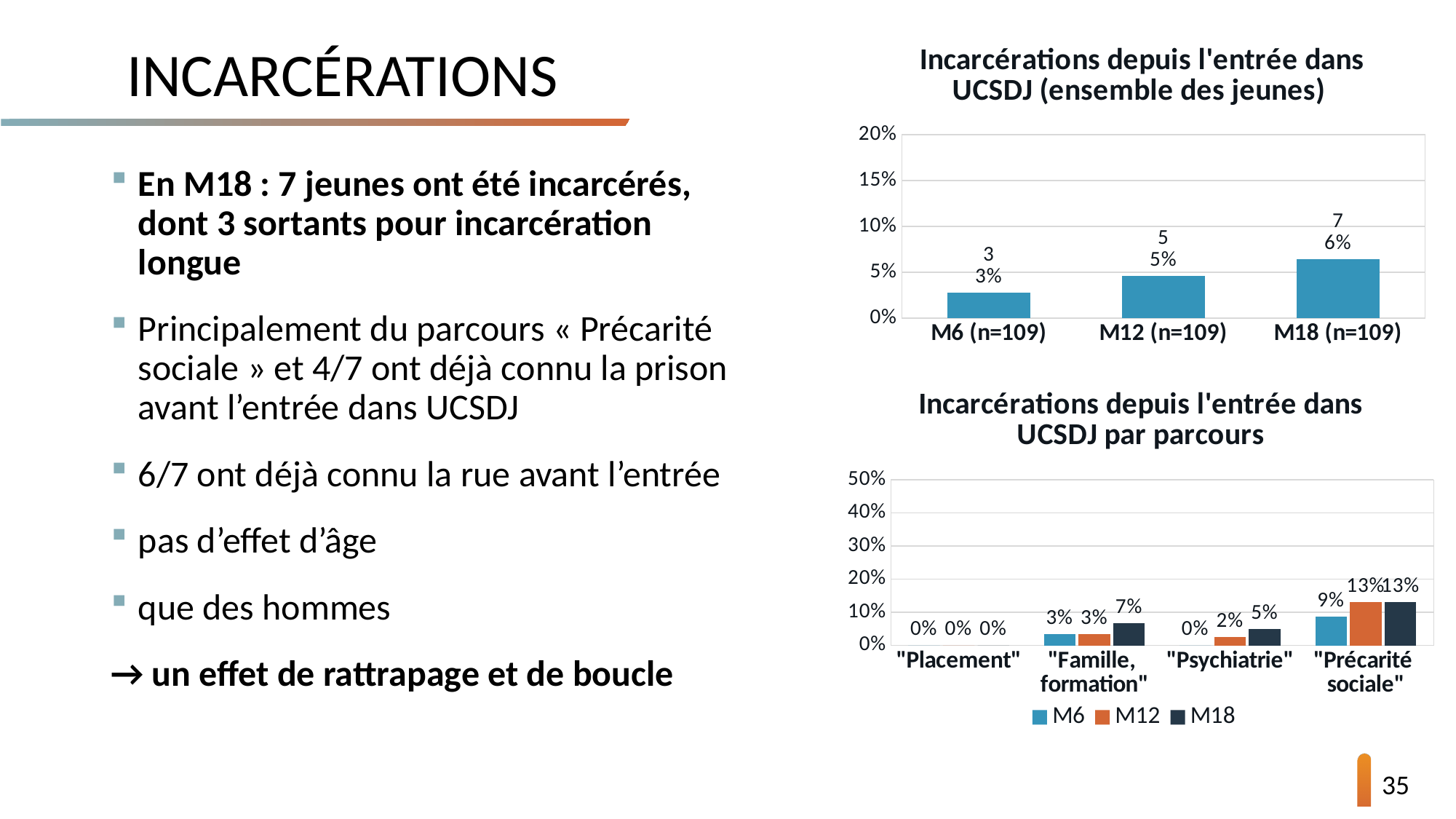
In the top chart 'Incarcérations depuis l'entrée dans UCSDJ (ensemble des jeunes)', which category has the lowest value? M6 (n=109) In the top chart 'Incarcérations depuis l'entrée dans UCSDJ (ensemble des jeunes)', do the values rise or fall from M6 to M18? rise In the bottom chart 'Incarcérations depuis l'entrée dans UCSDJ par parcours', what is the M6 value for "Précarité sociale"? 9% What kind of chart is the bottom chart 'Incarcérations depuis l'entrée dans UCSDJ par parcours'? bar chart In the bottom chart 'Incarcérations depuis l'entrée dans UCSDJ par parcours', what is the difference between the M18 and M12 values for "Psychiatrie"? 3% In the top chart 'Incarcérations depuis l'entrée dans UCSDJ (ensemble des jeunes)', how many categories are shown on the x axis? 3 In the bottom chart 'Incarcérations depuis l'entrée dans UCSDJ par parcours', what is the M18 value for "Famille, formation"? 7% In the bottom chart 'Incarcérations depuis l'entrée dans UCSDJ par parcours', which is larger: the M18 value for "Famille, formation" or the M18 value for "Psychiatrie"? "Famille, formation" In the top chart 'Incarcérations depuis l'entrée dans UCSDJ (ensemble des jeunes)', what count is labelled above the M18 (n=109) bar? 7 In the top chart 'Incarcérations depuis l'entrée dans UCSDJ (ensemble des jeunes)', what percentage is shown for M12 (n=109)? 5% In the bottom chart 'Incarcérations depuis l'entrée dans UCSDJ par parcours', how many series does the legend list? 3 In the bottom chart 'Incarcérations depuis l'entrée dans UCSDJ par parcours', which parcours has the highest M18 value? "Précarité sociale"